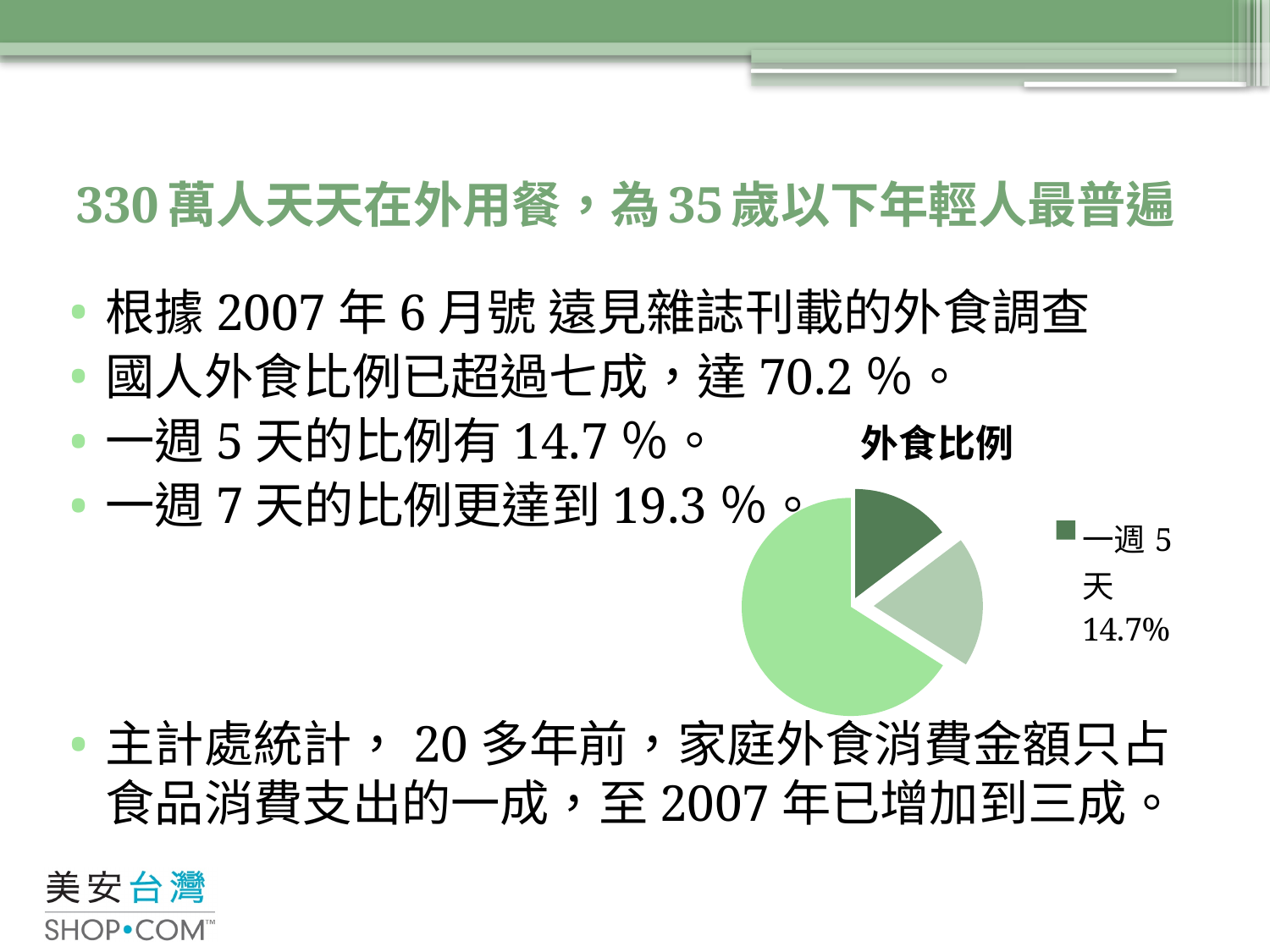
How many slices does the pie chart have? 3 What colour is the legend marker for 一週 5 天? dark green What kind of chart is shown on the slide? pie chart According to the chart legend, what is the value for 一週 5 天? 14.7% Is the 一週 5 天 slice the smallest slice of the pie chart? yes What is the title of the pie chart? 外食比例